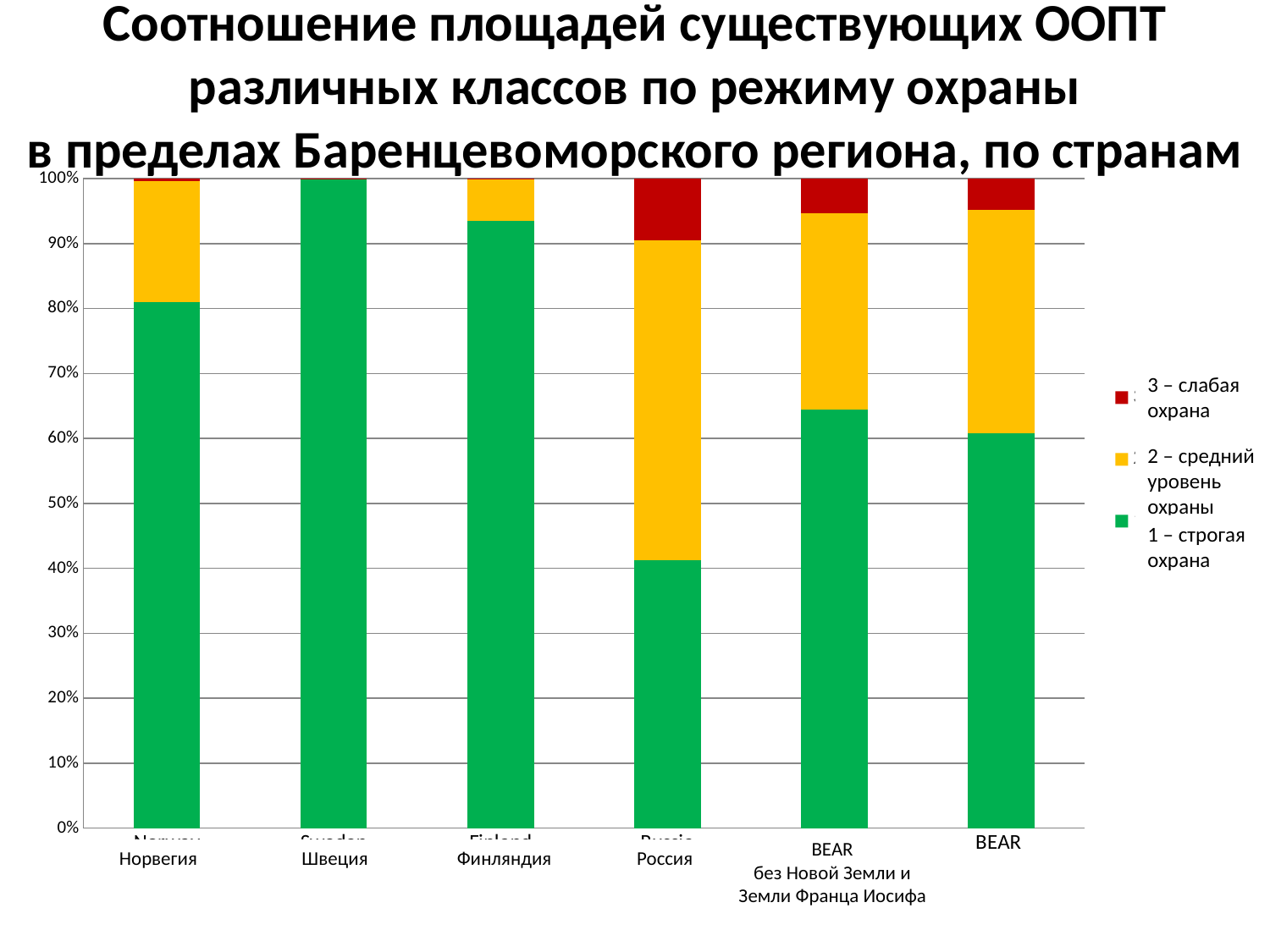
What kind of chart is shown on the slide? stacked bar chart Is the share of '1 – строгая охрана' for Норвегия greater or less than 70%? greater Which category has the smallest share of '1 – строгая охрана'? Россия Which has a larger share of '1 – строгая охрана': Норвегия or Финляндия? Финляндия Which has a larger share of '1 – строгая охрана': Россия or BEAR? BEAR Which category has the largest share of '1 – строгая охрана'? Швеция How many categories (countries/regions) are shown on the x axis? 6 Is the share of '1 – строгая охрана' for Финляндия greater or less than 90%? greater Is the share of '1 – строгая охрана' for Россия greater or less than 50%? less Which category's bar consists entirely of '1 – строгая охрана'? Швеция What colour represents '1 – строгая охрана' in the chart? green How many series does the legend list? 3